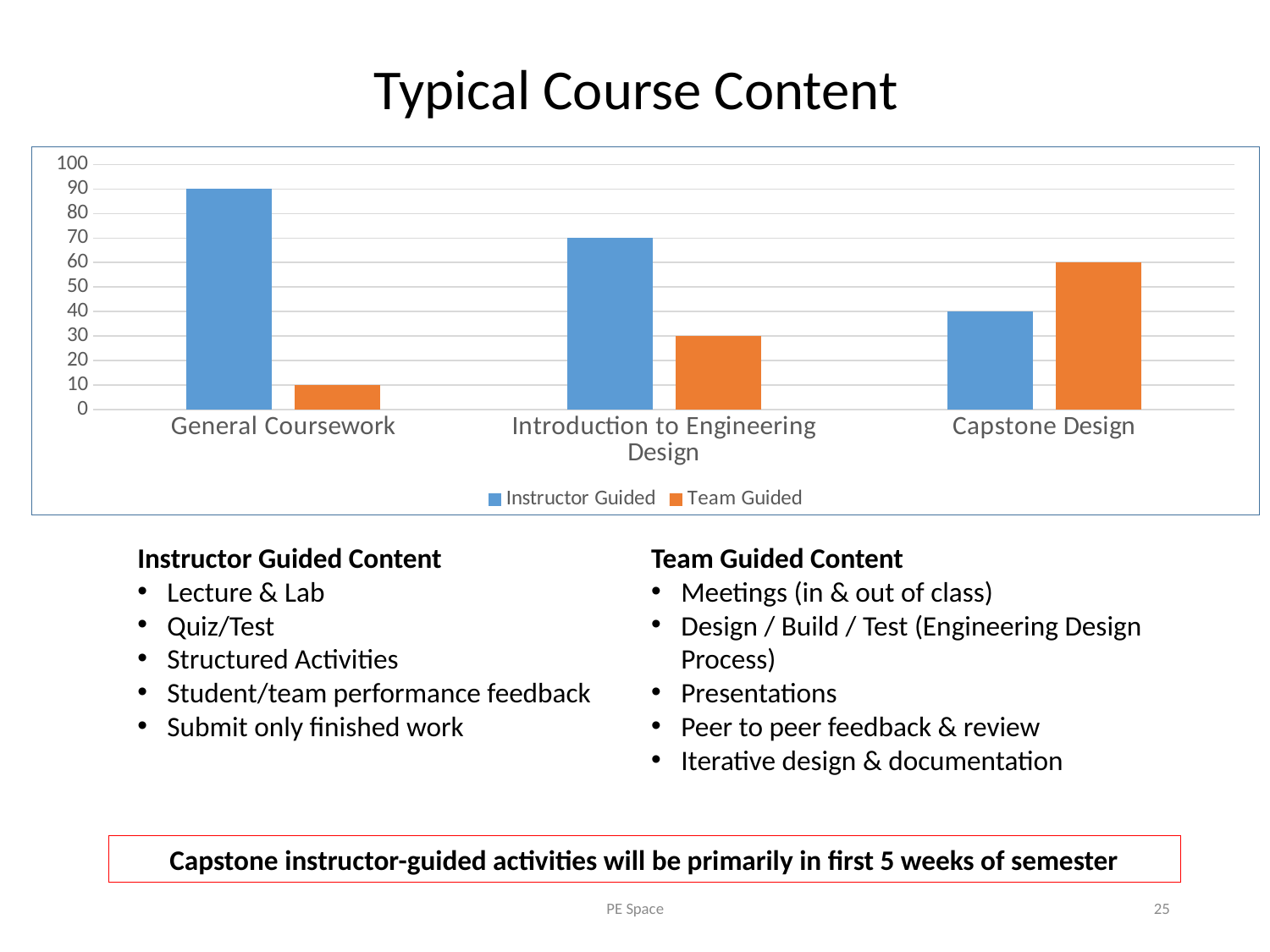
Do the Team Guided values rise or fall from General Coursework to Capstone Design? rise What is the Team Guided value for Capstone Design? 60 How many categories are shown on the x axis? 3 What is the difference between the Instructor Guided and Team Guided values for General Coursework? 80 For Capstone Design, which is larger: Instructor Guided or Team Guided? Team Guided What kind of chart is shown on the slide? bar chart Which category has the highest Instructor Guided value? General Coursework Is the Instructor Guided value for Introduction to Engineering Design greater or less than 50? greater What is the Instructor Guided value for General Coursework? 90 How many series does the legend list? 2 What is the Team Guided value for Introduction to Engineering Design? 30 Which category has the lowest Team Guided value? General Coursework